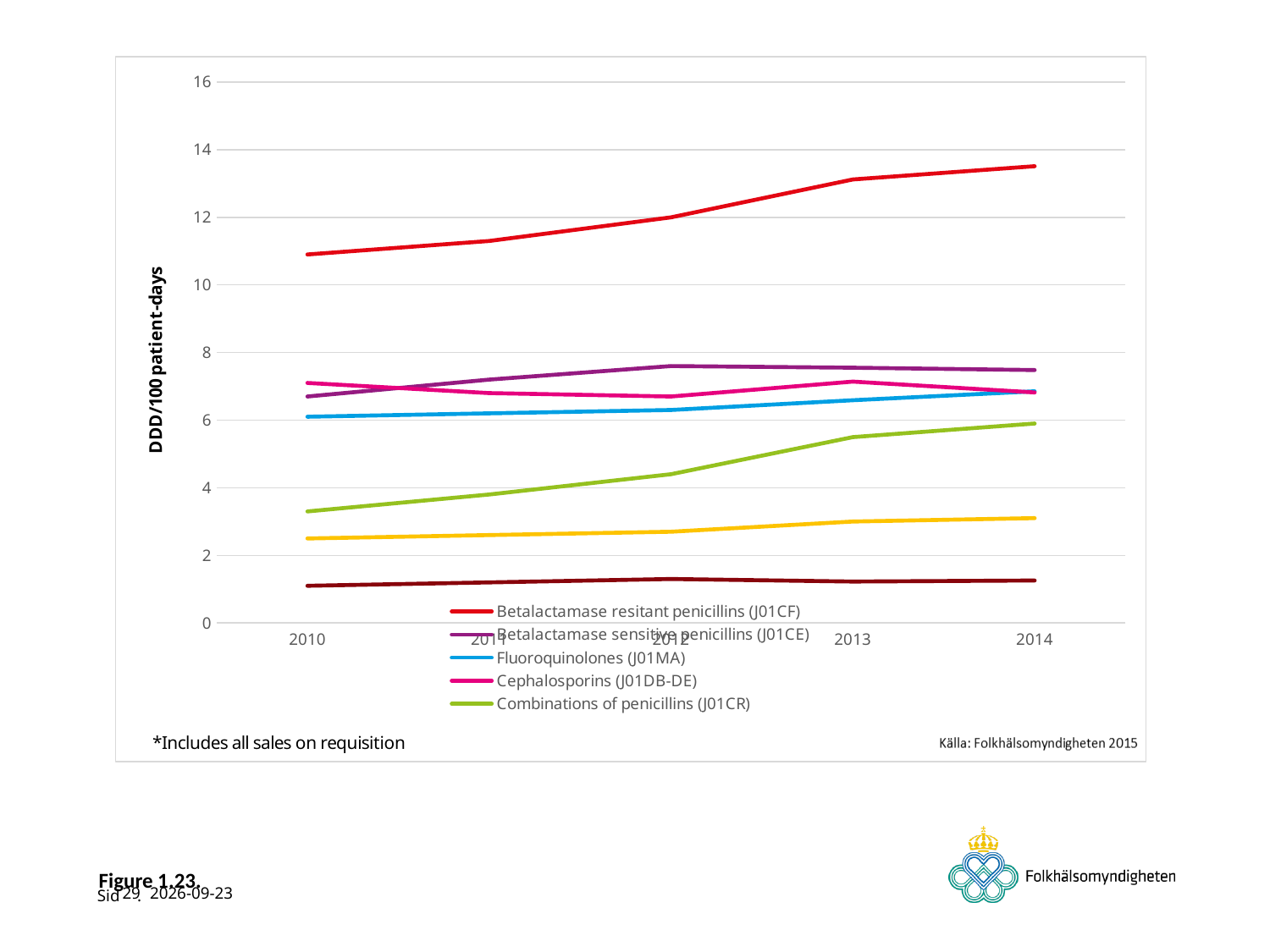
Is the value for Combinations of penicillins (J01CR) in 2010 greater or less than 4? less Does the value for Combinations of penicillins (J01CR) rise or fall from 2010 to 2014? Rise Is the value for Betalactamase resistant penicillins (J01CF) in 2014 greater or less than 12? greater How many years are shown along the x axis? 5 In 2014, which is higher: Betalactamase sensitive penicillins (J01CE) or Combinations of penicillins (J01CR)? Betalactamase sensitive penicillins (J01CE) Does the value for Betalactamase resistant penicillins (J01CF) rise or fall from 2010 to 2014? Rise What is the title of the y axis? DDD/100 patient-days Which series has the highest value in 2014? Betalactamase resistant penicillins (J01CF) Is the value for Fluoroquinolones (J01MA) in 2012 greater or less than 8? less In 2010, which is higher: Cephalosporins (J01DB-DE) or Fluoroquinolones (J01MA)? Cephalosporins (J01DB-DE) What kind of chart is shown on the slide? Line chart How many series does the legend list? 5